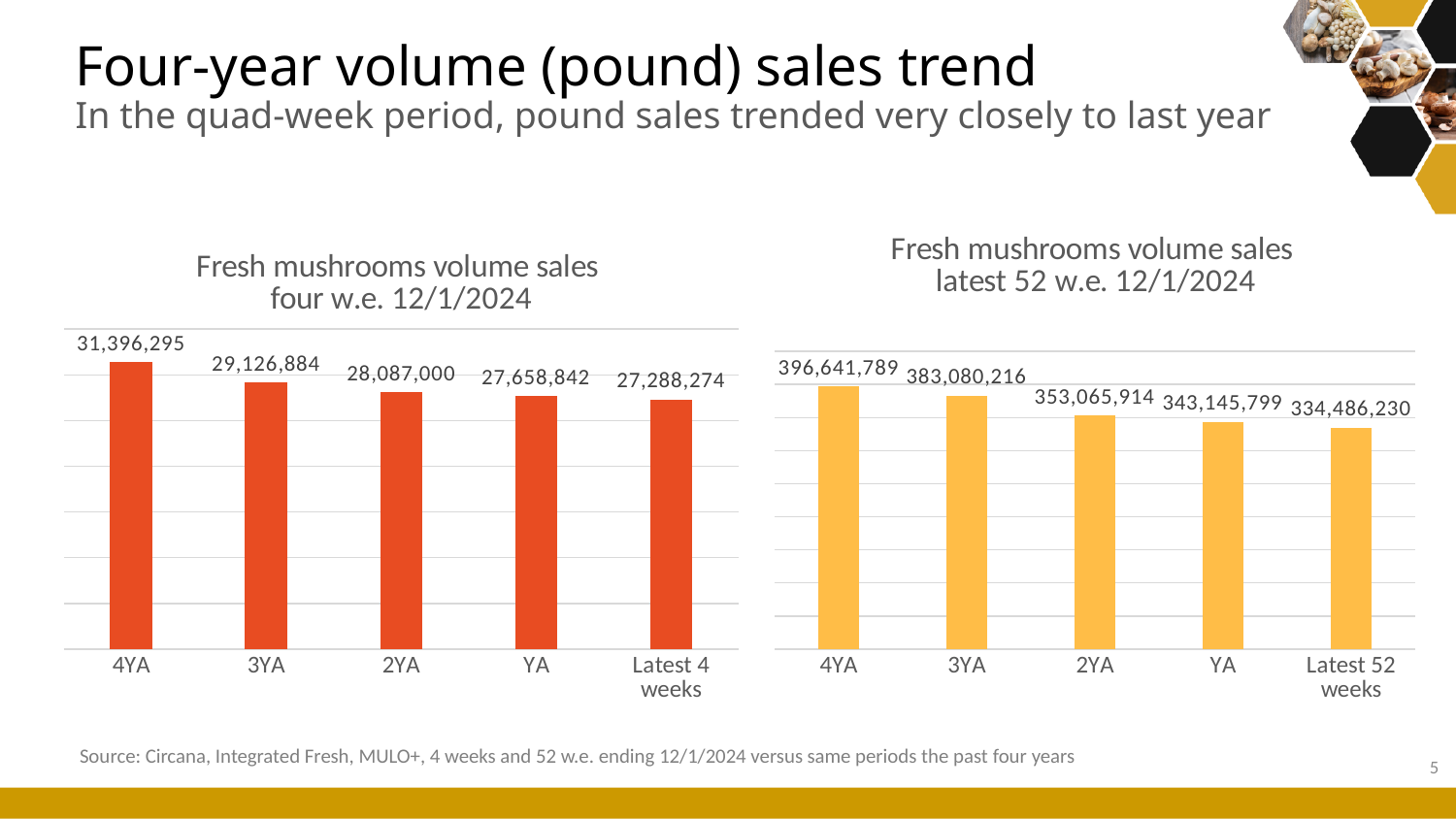
In the 'Fresh mushrooms volume sales latest 52 w.e. 12/1/2024' chart, what is the difference between the 4YA value and the 3YA value? 13,561,573 In the 'Fresh mushrooms volume sales latest 52 w.e. 12/1/2024' chart, what is the value for YA? 343,145,799 What kind of chart is the 'Fresh mushrooms volume sales latest 52 w.e. 12/1/2024' chart? Bar chart In the 'Fresh mushrooms volume sales latest 52 w.e. 12/1/2024' chart, which is larger, the value for 3YA or the value for YA? 3YA In the 'Fresh mushrooms volume sales four w.e. 12/1/2024' chart, what is the difference between the 4YA value and the Latest 4 weeks value? 4,108,021 In the 'Fresh mushrooms volume sales four w.e. 12/1/2024' chart, what is the value for Latest 4 weeks? 27,288,274 How many categories are shown in the 'Fresh mushrooms volume sales four w.e. 12/1/2024' chart? 5 In the 'Fresh mushrooms volume sales latest 52 w.e. 12/1/2024' chart, what is the value for 2YA? 353,065,914 In the 'Fresh mushrooms volume sales four w.e. 12/1/2024' chart, what is the value for 3YA? 29,126,884 In the 'Fresh mushrooms volume sales four w.e. 12/1/2024' chart, do the values rise or fall from 4YA to Latest 4 weeks? Fall In the 'Fresh mushrooms volume sales four w.e. 12/1/2024' chart, which category has the highest value? 4YA In the 'Fresh mushrooms volume sales latest 52 w.e. 12/1/2024' chart, which category has the lowest value? Latest 52 weeks